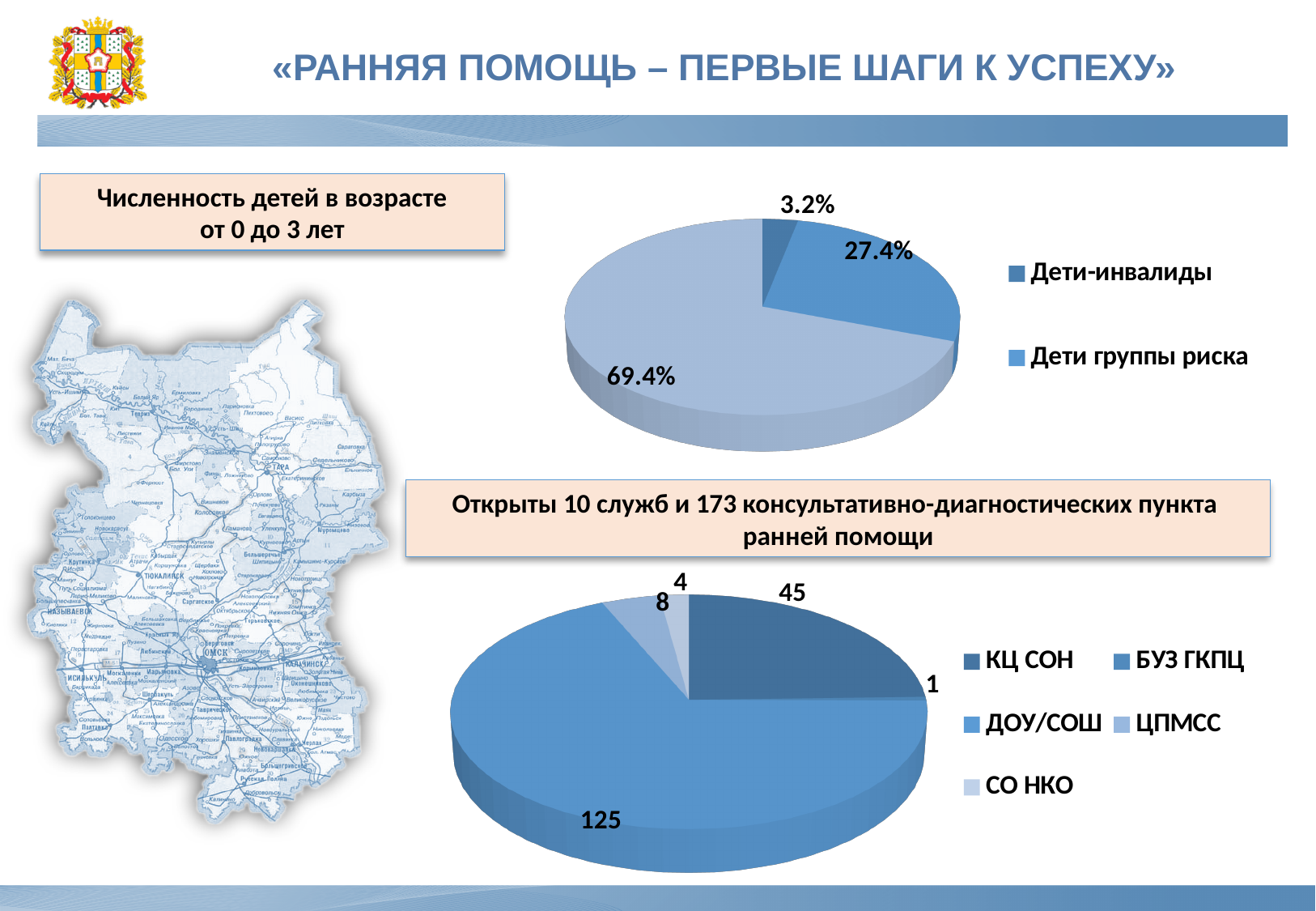
In the bottom pie chart, what is the difference between the values for ДОУ/СОШ and КЦ СОН? 80 In the top pie chart (Численность детей в возрасте от 0 до 3 лет), what share is shown for Дети-инвалиды? 3.2% In the bottom pie chart, what is the value for КЦ СОН? 45 In the bottom pie chart, which category has the smallest value? БУЗ ГКПЦ In the top pie chart, what is the largest percentage label shown? 69.4% In the top pie chart, how many entries does the legend list? 2 In the top pie chart (Численность детей в возрасте от 0 до 3 лет), what share is shown for Дети группы риска? 27.4% In the bottom pie chart, how many categories does the legend list? 5 What type of chart is the top chart on the slide? Pie chart In the bottom pie chart, which is larger: ЦПМСС or СО НКО? ЦПМСС In the top pie chart, how many slices does the pie have? 3 In the bottom pie chart, what is the value for ДОУ/СОШ? 125